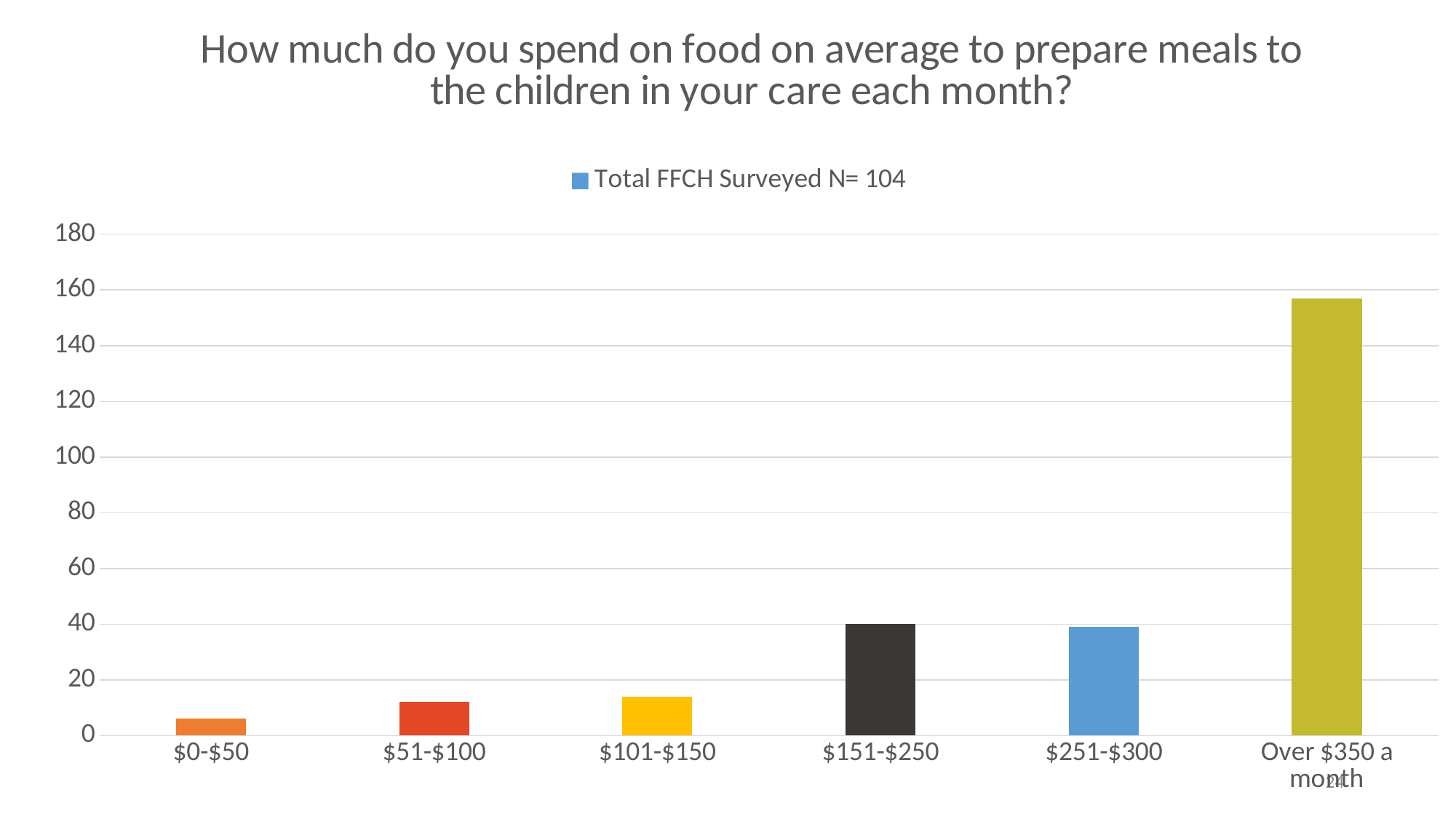
How many series does the legend list? 1 Is the value for $151-$250 greater or less than 60? less Is the value for $251-$300 greater or less than 20? greater What kind of chart is shown on the slide? bar chart How many categories are shown on the x axis? 6 What is the legend entry shown on the chart? Total FFCH Surveyed N= 104 Which is larger, the value for $51-$100 or the value for $151-$250? $151-$250 Which is larger, the value for $0-$50 or the value for $101-$150? $101-$150 Is the value for $0-$50 greater or less than 20? less Which category has the highest value? Over $350 a month Which category has the lowest value? $0-$50